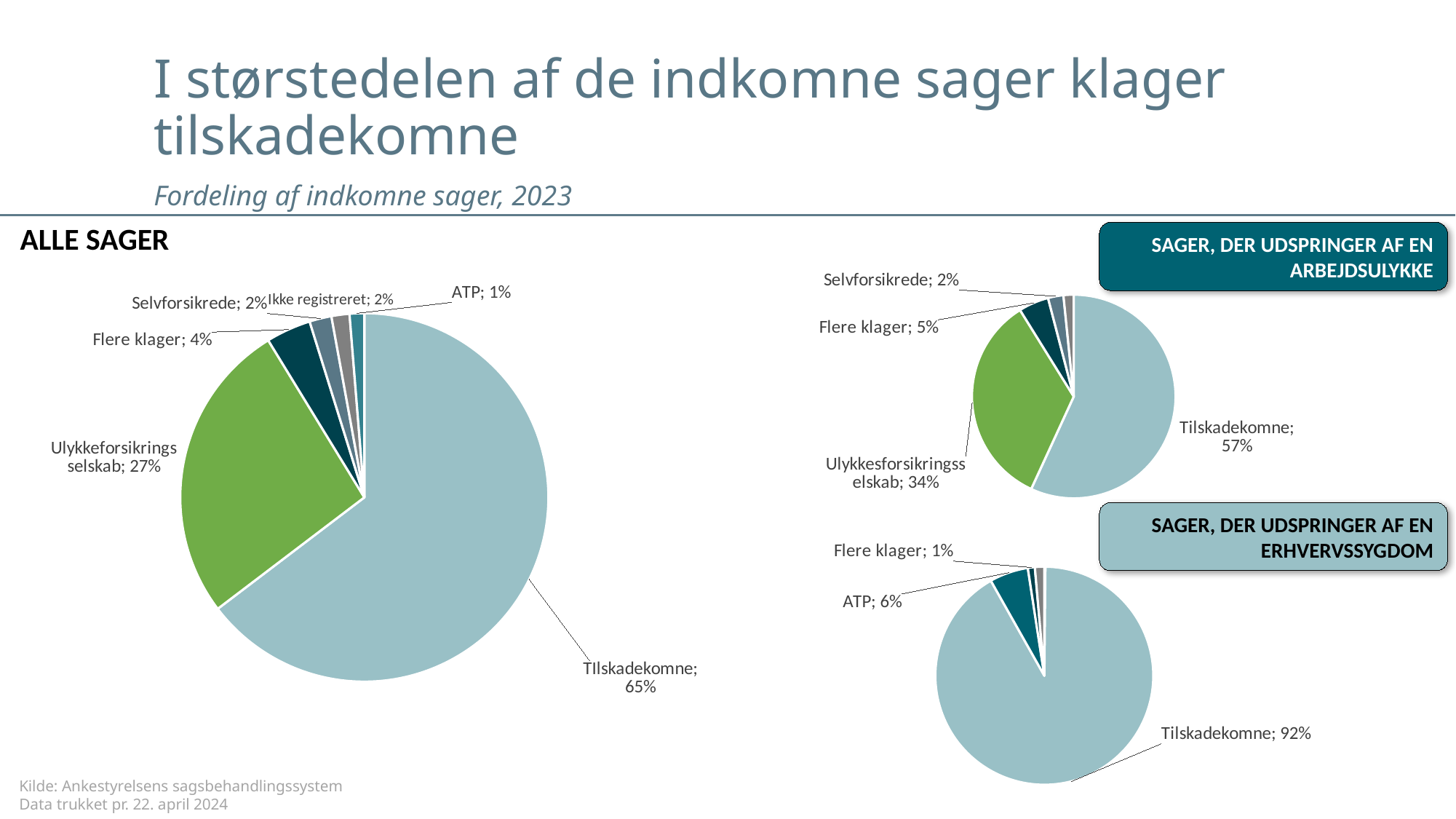
In the 'ALLE SAGER' pie chart, what share is labelled Ulykkeforsikringsselskab? 27% In the 'ALLE SAGER' pie chart, which category has the smallest share? ATP In the 'ALLE SAGER' pie chart, which category has the largest share? Tilskadekomne What kind of chart is used for 'ALLE SAGER'? Pie chart How many labelled slices does the 'ALLE SAGER' pie chart have? 6 In the 'SAGER, DER UDSPRINGER AF EN ARBEJDSULYKKE' pie chart, what share is labelled Tilskadekomne? 57% In the 'SAGER, DER UDSPRINGER AF EN ERHVERVSSYGDOM' pie chart, which is larger: ATP or Flere klager? ATP In the 'SAGER, DER UDSPRINGER AF EN ERHVERVSSYGDOM' pie chart, what share is labelled Tilskadekomne? 92% In the 'ALLE SAGER' pie chart, what is the difference in percentage points between Tilskadekomne and Ulykkeforsikringsselskab? 38 In the 'SAGER, DER UDSPRINGER AF EN ARBEJDSULYKKE' pie chart, what share is labelled Ulykkesforsikringsselskab? 34% In the 'ALLE SAGER' pie chart, what share of cases is labelled Tilskadekomne? 65% What is the subtitle shown under the slide title? Fordeling af indkomne sager, 2023